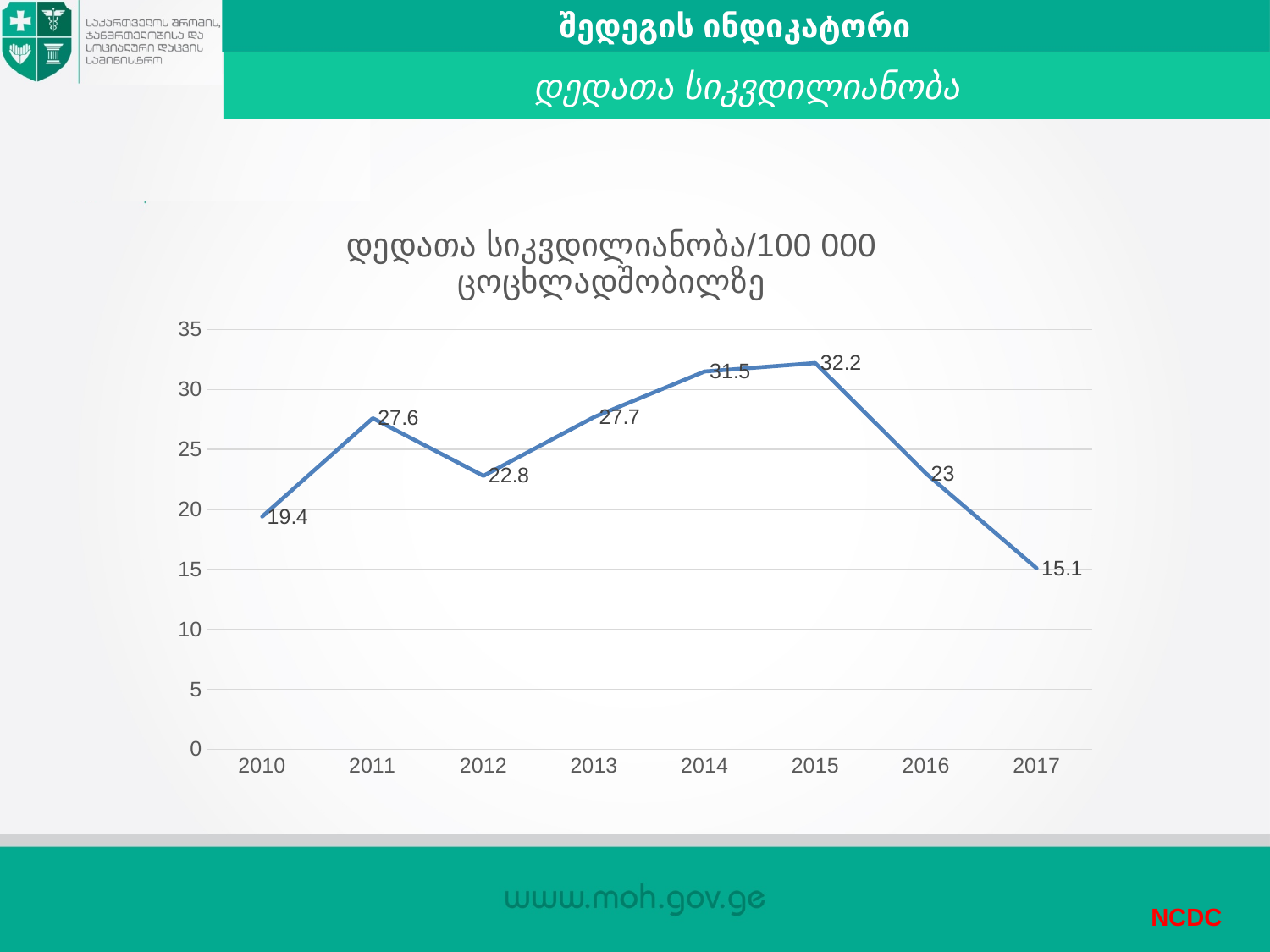
Is the value for 2014 greater or less than 30? greater Which year has the highest value? 2015 What is the difference between the values for 2011 and 2012? 4.8 Do the values rise or fall from 2015 to 2017? fall Which year has the lowest value? 2017 What is the value for 2010? 19.4 What kind of chart is shown on the slide? line chart What is the difference between the values for 2015 and 2017? 17.1 What is the value for 2015? 32.2 Which is larger, the value for 2013 or the value for 2016? 2013 What is the value for 2017? 15.1 How many years are plotted on the x axis? 8